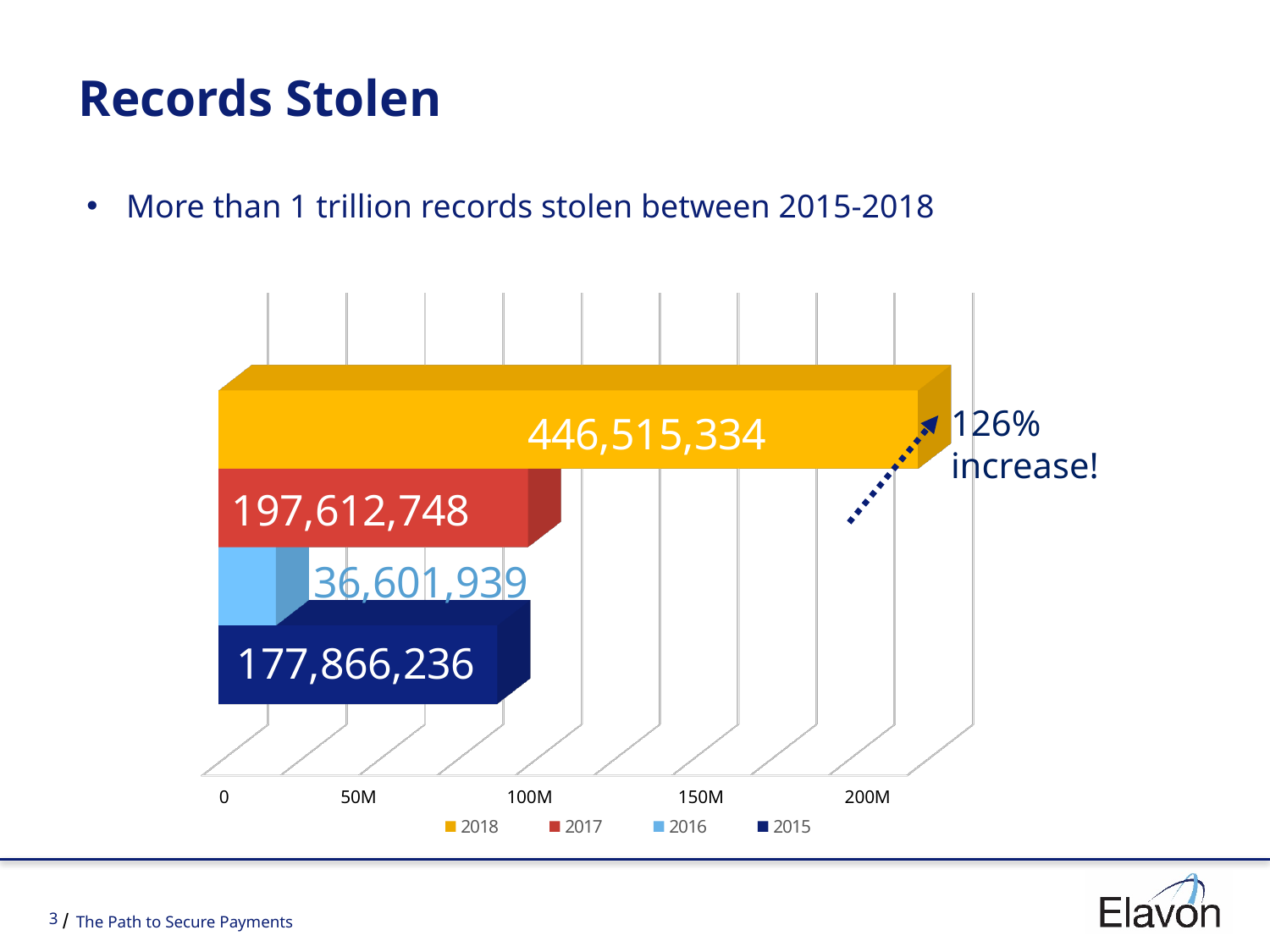
Which is larger, the value for 2017 or the value for 2015? 2017 What is the difference between the values for 2017 and 2015? 19,746,512 Which year has the lowest number of records stolen? 2016 What is the value for 2018? 446,515,334 What percentage increase is annotated next to the 2018 bar? 126% increase! How many series does the legend list? 4 What is the value for 2016? 36,601,939 What is the value for 2015? 177,866,236 What is the value for 2017? 197,612,748 What kind of chart is shown on the slide? Bar chart Which year has the highest number of records stolen? 2018 What is the difference between the values for 2018 and 2017? 248,902,586